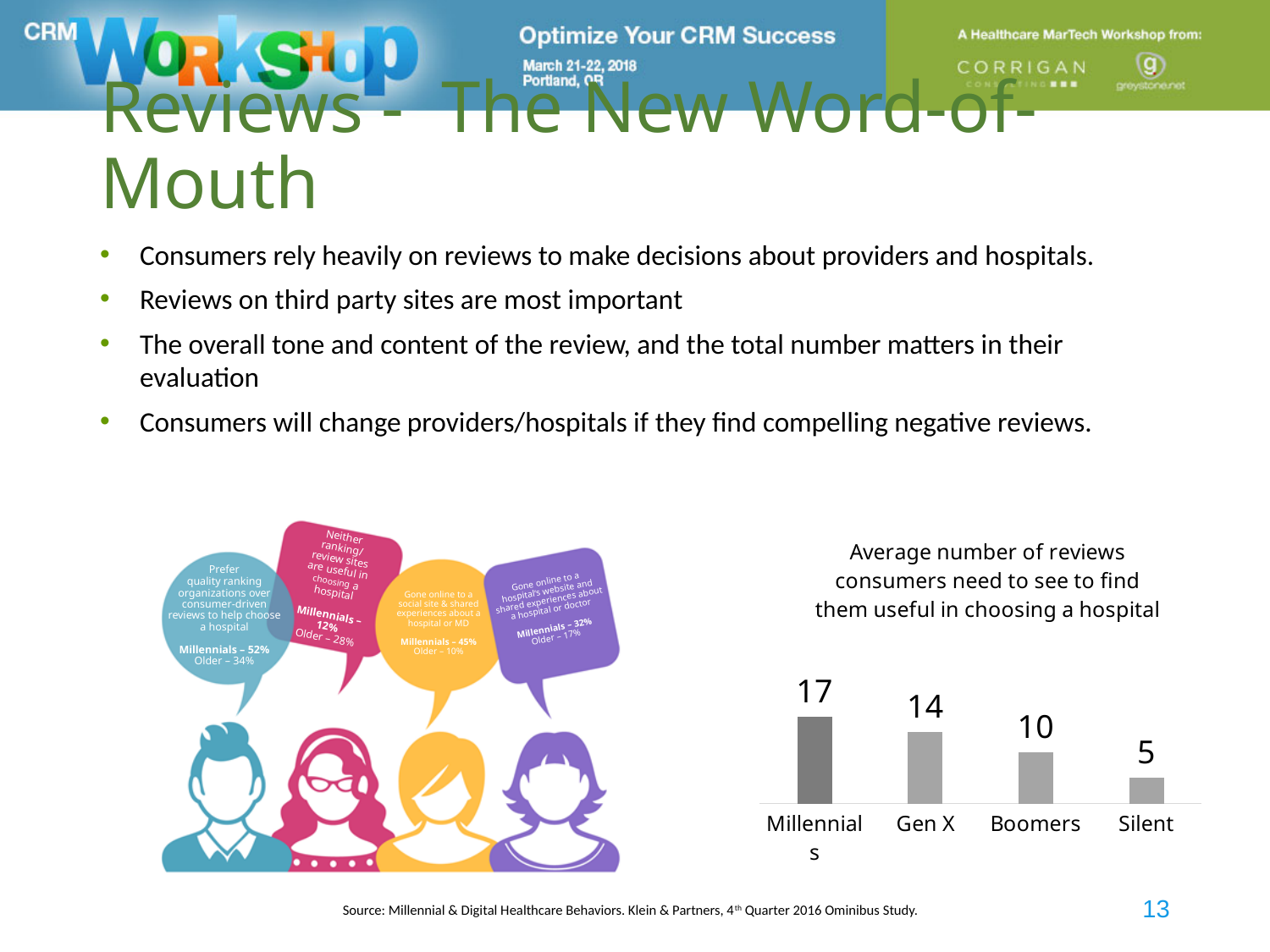
What is the value for Silent in the chart of average number of reviews needed? 5 What is the difference between the values for Gen X and Boomers in the reviews chart? 4 What is the average number of reviews Millennials need to see to find them useful in choosing a hospital? 17 What is the value for Boomers in the chart of average number of reviews needed? 10 What is the value for Gen X in the chart of average number of reviews needed? 14 Which needs more reviews on average, Gen X or Boomers? Gen X Do the values in the average number of reviews chart rise or fall from Millennials to Silent? Fall What kind of chart shows the average number of reviews consumers need to see? Bar chart Which generation needs the lowest average number of reviews to find them useful in choosing a hospital? Silent How many generations are shown in the chart of average number of reviews needed? 4 What is the difference between the average number of reviews needed by Millennials and by Silent? 12 Which generation needs the highest average number of reviews to find them useful in choosing a hospital? Millennials